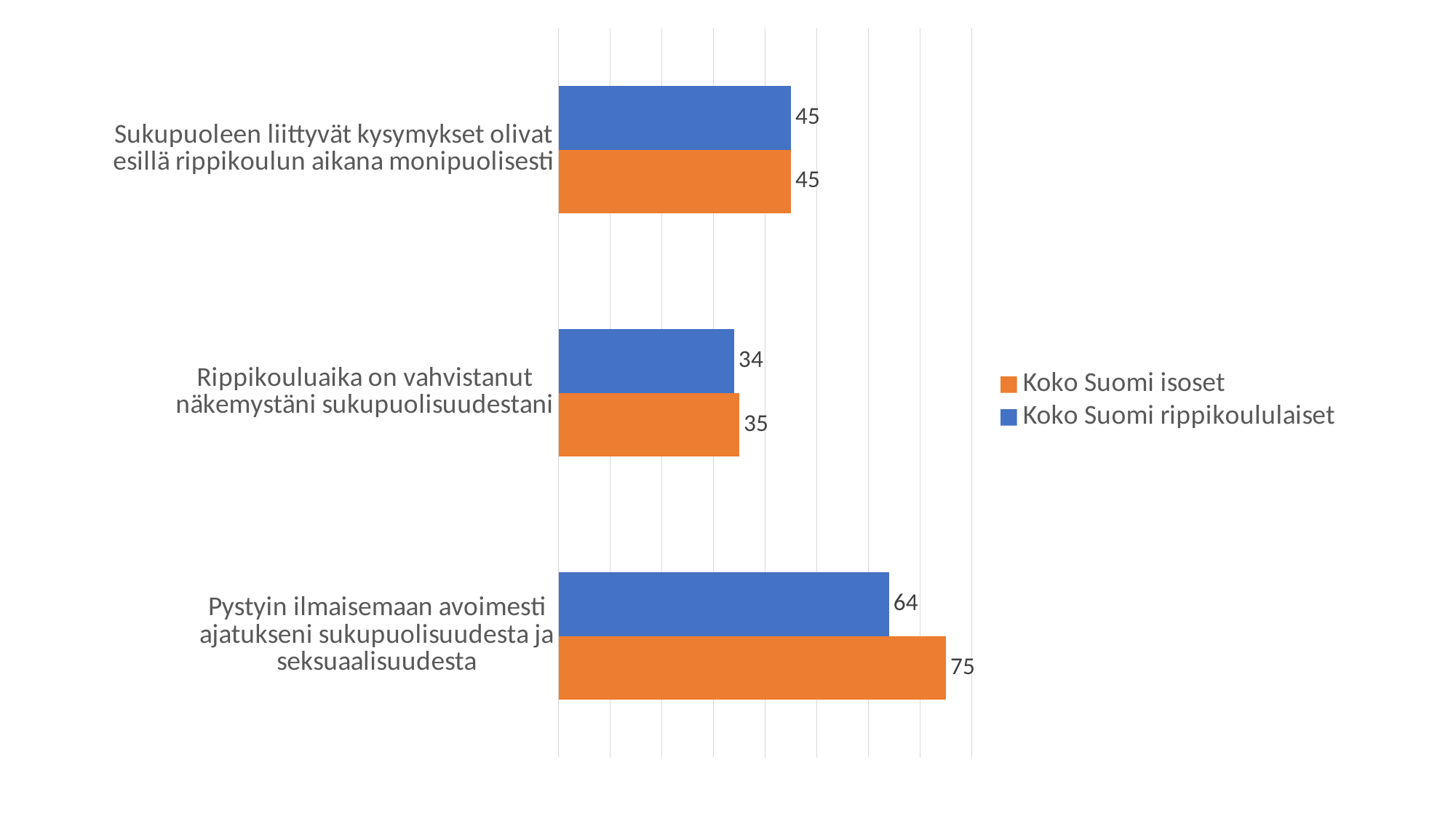
What is the value for "Koko Suomi rippikoululaiset" in the category "Pystyin ilmaisemaan avoimesti ajatukseni sukupuolisuudesta ja seksuaalisuudesta"? 64 How many series does the legend list? 2 Which category has the highest value for "Koko Suomi isoset"? Pystyin ilmaisemaan avoimesti ajatukseni sukupuolisuudesta ja seksuaalisuudesta In the category "Pystyin ilmaisemaan avoimesti ajatukseni sukupuolisuudesta ja seksuaalisuudesta", which series has the larger value, "Koko Suomi isoset" or "Koko Suomi rippikoululaiset"? Koko Suomi isoset What is the value for "Koko Suomi isoset" in the category "Pystyin ilmaisemaan avoimesti ajatukseni sukupuolisuudesta ja seksuaalisuudesta"? 75 Which category has the lowest value for "Koko Suomi rippikoululaiset"? Rippikouluaika on vahvistanut näkemystäni sukupuolisuudestani What kind of chart is shown on the slide? Bar chart How many categories are shown in the chart? 3 What is the value for "Koko Suomi rippikoululaiset" in the category "Rippikouluaika on vahvistanut näkemystäni sukupuolisuudestani"? 34 What is the value for "Koko Suomi isoset" in the category "Sukupuoleen liittyvät kysymykset olivat esillä rippikoulun aikana monipuolisesti"? 45 What is the difference between "Koko Suomi isoset" and "Koko Suomi rippikoululaiset" in the category "Rippikouluaika on vahvistanut näkemystäni sukupuolisuudestani"? 1 What is the difference between "Koko Suomi isoset" and "Koko Suomi rippikoululaiset" in the category "Pystyin ilmaisemaan avoimesti ajatukseni sukupuolisuudesta ja seksuaalisuudesta"? 11